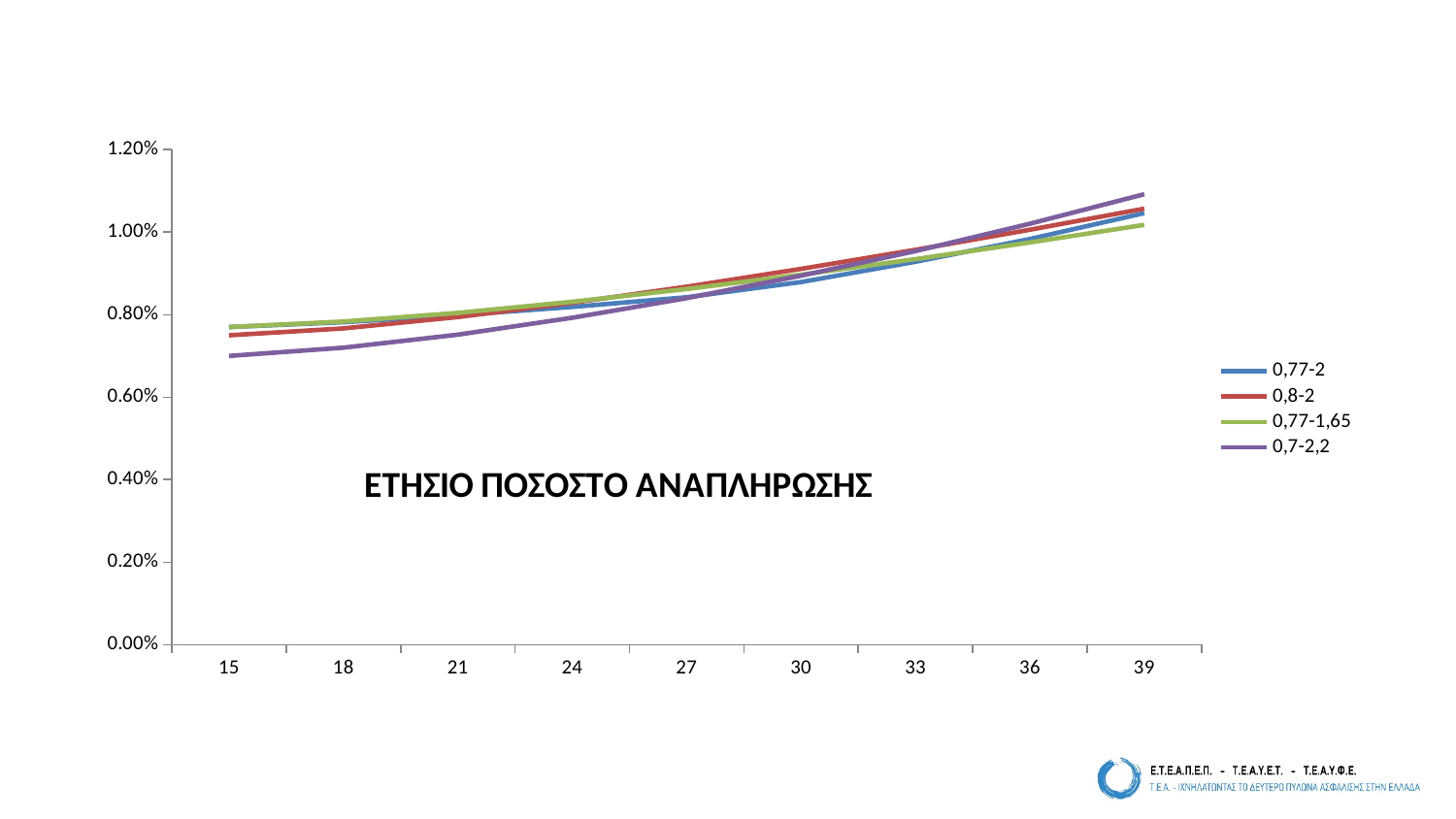
Is the value of the 0,7-2,2 series at x = 15 greater or less than 0.80%? less How many labelled tick values are shown on the x axis? 9 How many series does the legend list? 4 Which series has the highest value at x = 39? 0,7-2,2 Which series is drawn in purple? 0,7-2,2 Is the value of the 0,7-2,2 series at x = 39 greater or less than 1.00%? greater Which series has the lowest value at x = 15? 0,7-2,2 Is the value of the 0,77-1,65 series at x = 15 greater or less than 0.80%? less What is the title of the chart? ΕΤΗΣΙΟ ΠΟΣΟΣΤΟ ΑΝΑΠΛΗΡΩΣΗΣ At x = 15, which is larger: the value of the 0,77-1,65 series or the value of the 0,7-2,2 series? 0,77-1,65 Do the values of the 0,7-2,2 series rise or fall as the x axis goes from 15 to 39? rise What kind of chart is shown on the slide? line chart